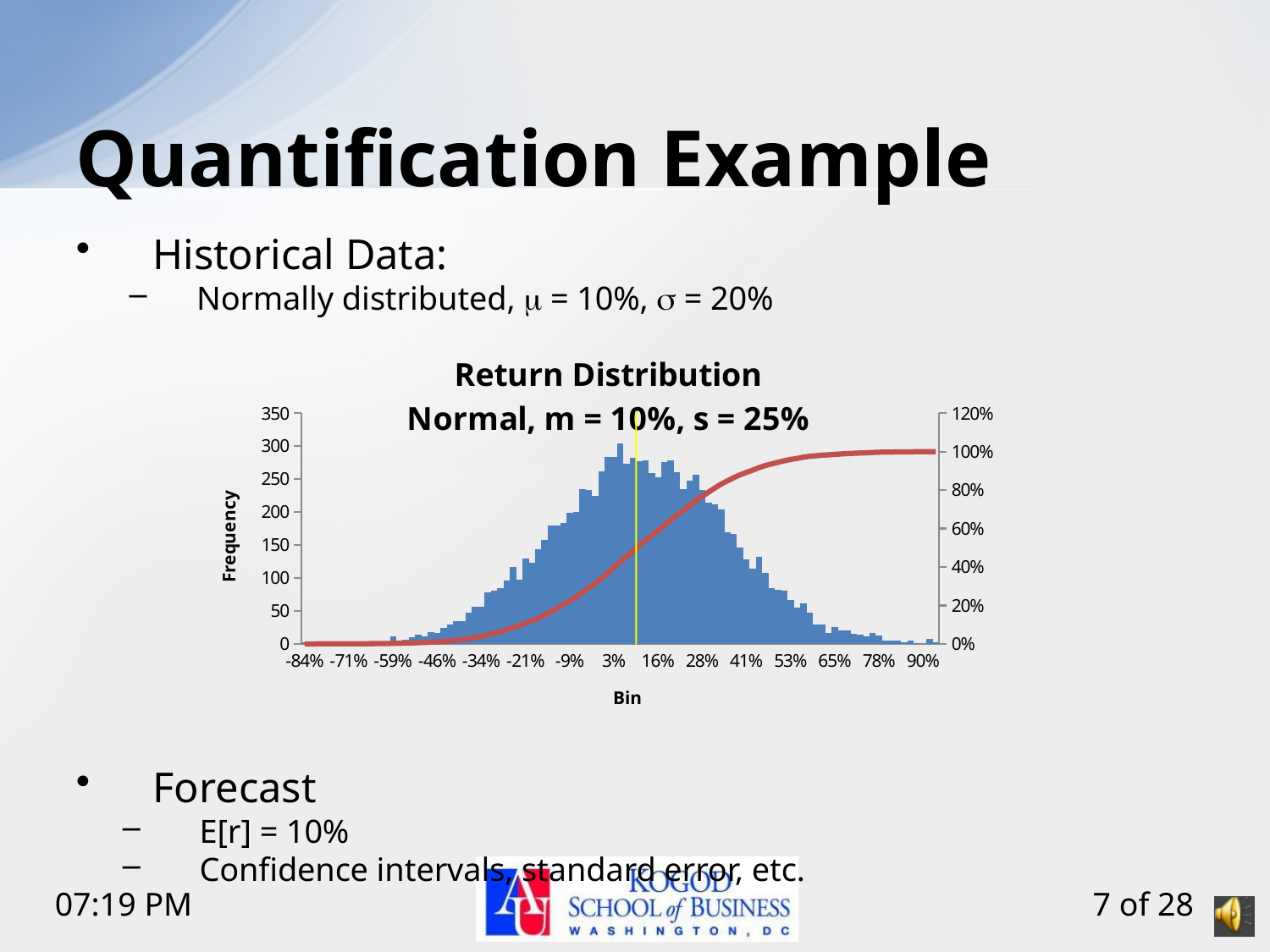
What is the label on the left vertical axis of the chart? Frequency What is the highest tick value shown on the left vertical axis? 350 What is the title of the chart? Return Distribution Normal, m = 10%, s = 25% Which bin has the higher frequency, 3% or 65%? 3% Is the cumulative percentage (red line) at the bin labelled 53% greater or less than 80%? greater Is the cumulative percentage (red line) at the bin labelled -34% greater or less than 20%? less How many bin labels are shown along the x axis? 15 Does the red cumulative line rise or fall as the bin values increase along the x axis? rise What kind of chart is shown on the slide? combination bar and line chart Is the frequency for the bin labelled 90% greater or less than 50? less